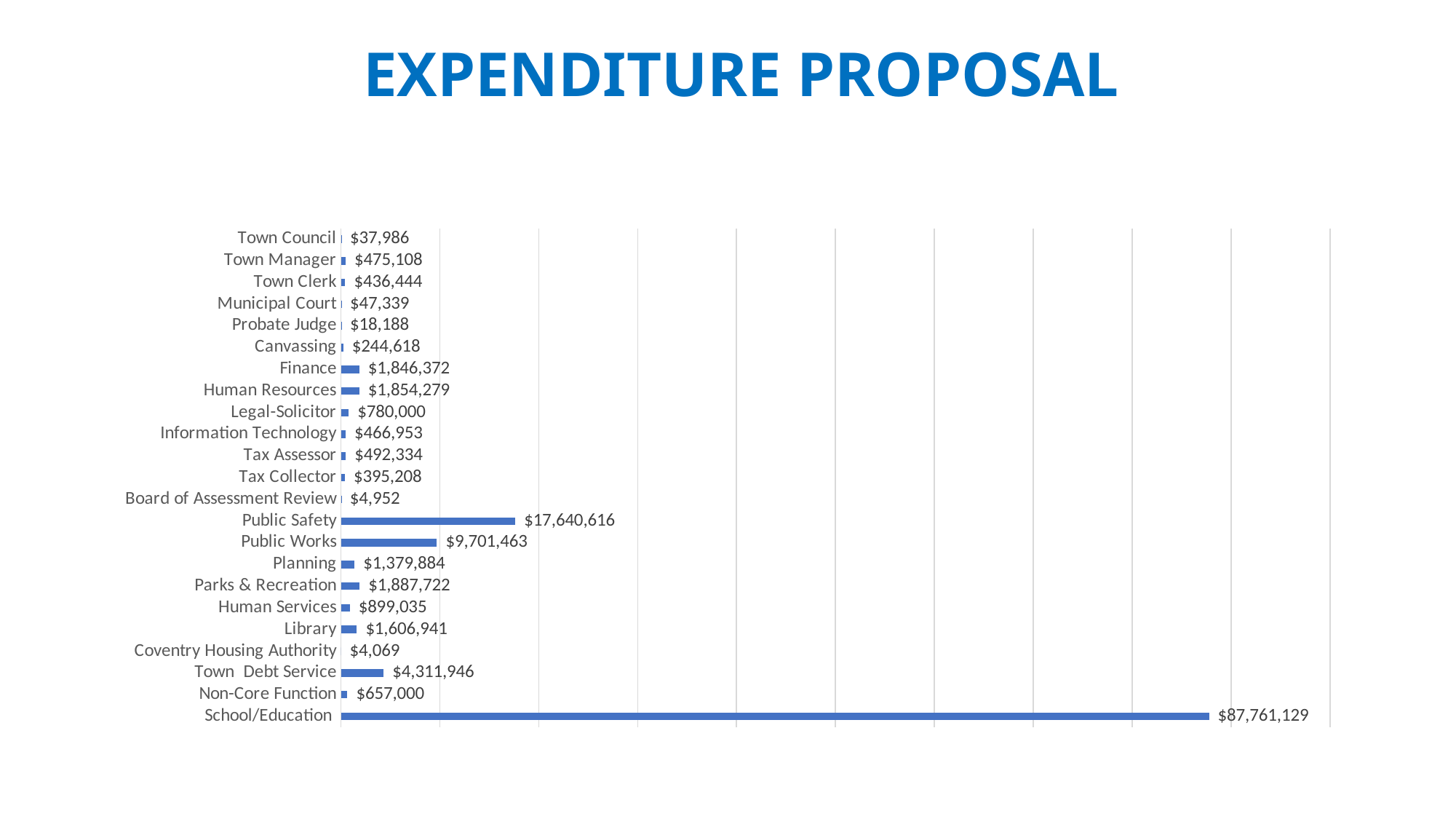
Which is larger, the value for Parks & Recreation or the value for Library? Parks & Recreation What is the difference between the values for Town Manager and Town Clerk? $38,664 Which is larger, the value for Human Resources or the value for Finance? Human Resources What kind of chart is shown on the slide? Bar chart What is the value for Library? $1,606,941 What is the difference between the values for Public Safety and Public Works? $7,939,153 Which category has the lowest value? Coventry Housing Authority What is the value for Town Debt Service? $4,311,946 What is the value for Public Safety? $17,640,616 What is the value for Probate Judge? $18,188 How many categories are shown in the chart? 23 Which category has the highest value? School/Education